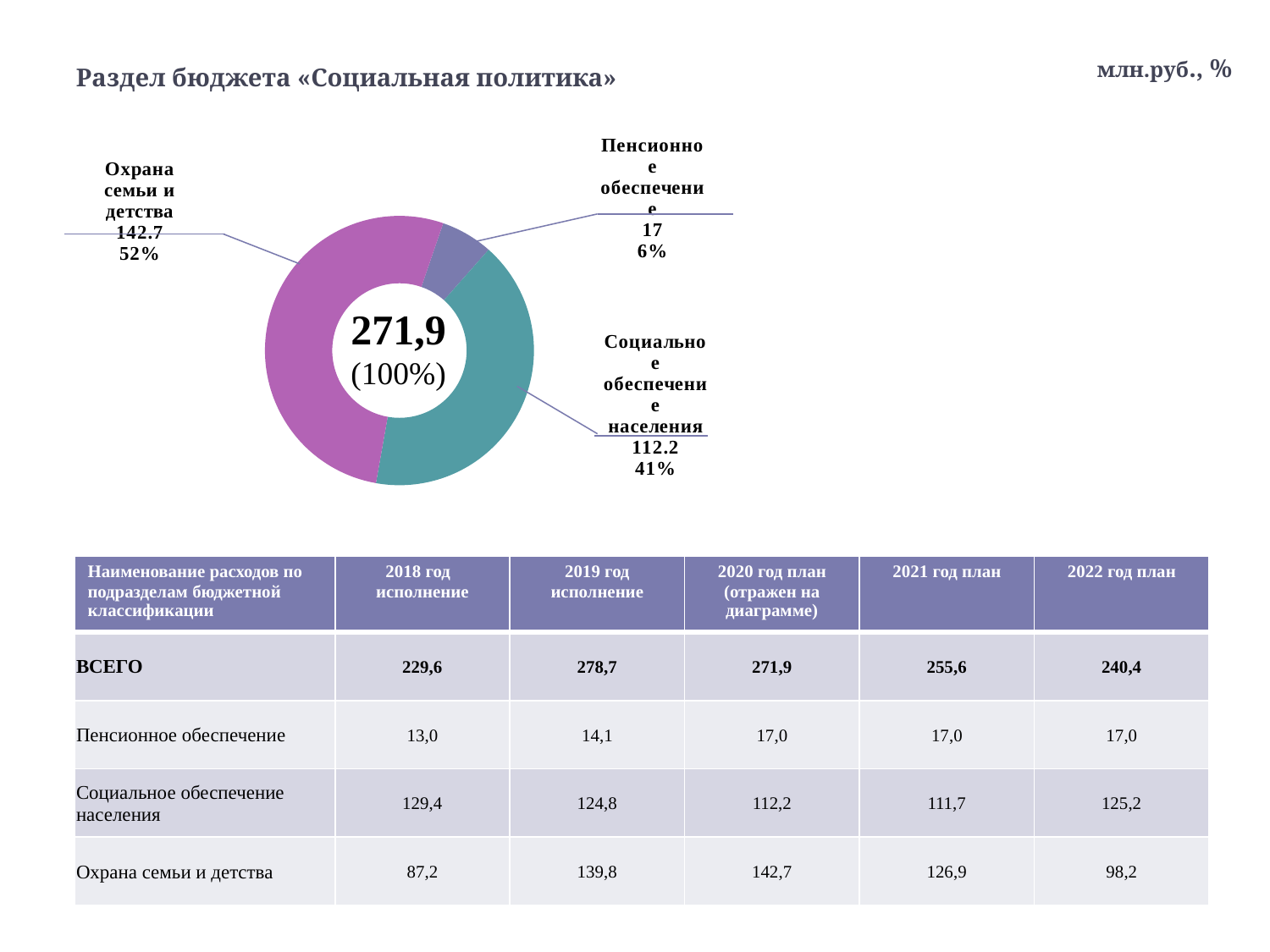
What share of the chart does «Охрана семьи и детства» represent? 52% What share of the chart does «Социальное обеспечение населения» represent? 41% What value is shown for «Охрана семьи и детства» on the chart? 142.7 How many slices does the doughnut chart have? 3 What kind of chart is shown on the slide? Doughnut (pie) chart What is the difference between the values for «Охрана семьи и детства» and «Социальное обеспечение населения» on the chart? 30.5 What value is shown for «Пенсионное обеспечение» on the chart? 17 What total value is shown in the centre of the doughnut chart? 271,9 Which slice of the chart is the largest? Охрана семьи и детства Which slice of the chart is the smallest? Пенсионное обеспечение What value is shown for «Социальное обеспечение населения» on the chart? 112.2 What share of the chart does «Пенсионное обеспечение» represent? 6%